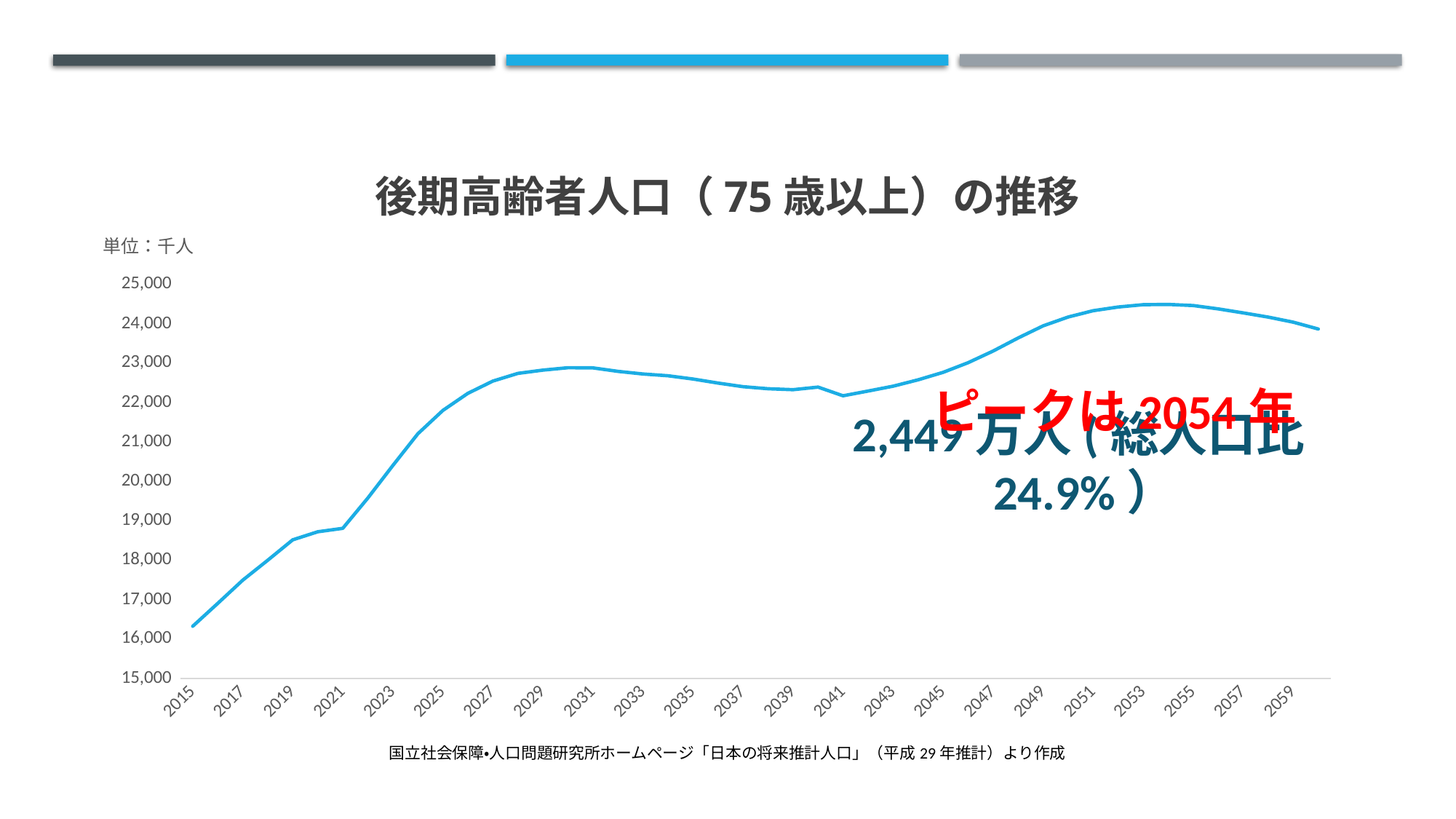
What kind of chart is shown on the slide? line chart What unit is stated for the values on the chart? 千人 In which year shown on the x axis is the plotted value lowest? 2015 According to the annotation on the chart, in which year does the population peak? 2054年 Is the value for 2021 greater or less than 19,000? less Is the value for 2015 greater or less than 17,000? less Does the plotted value rise or fall from 2015 to 2029? rise Is the value for 2029 greater or less than 22,000? greater How many year labels are shown on the x axis? 23 Which year has the larger value, 2015 or 2059? 2059 What is the title of the chart? 後期高齢者人口（75歳以上）の推移